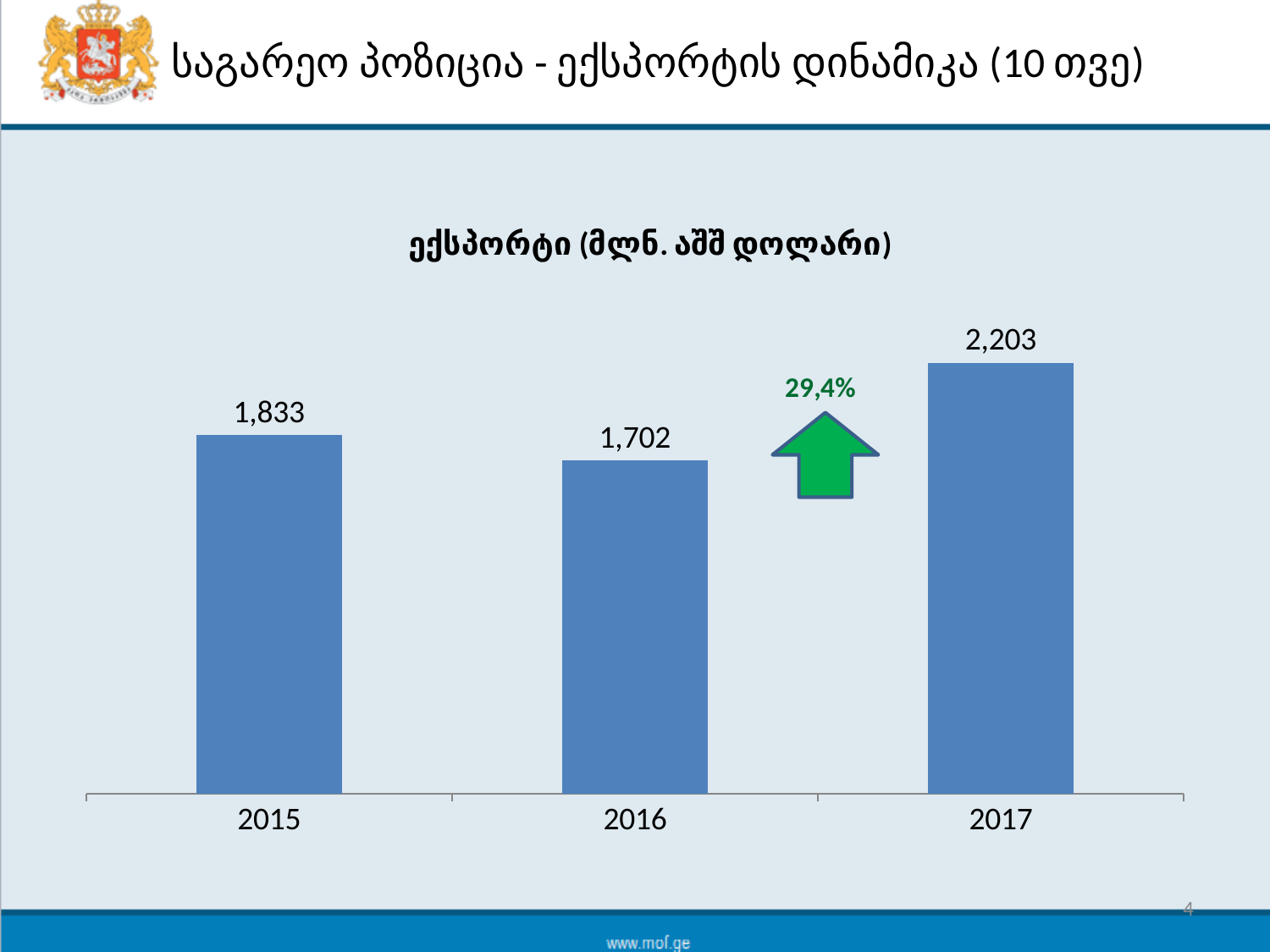
Which year has the highest export value? 2017 How many years are shown on the chart? 3 What is the difference between the export values for 2017 and 2016? 501 Which is larger, the export value for 2015 or for 2017? 2017 What is the export value for 2015? 1,833 What percentage change is shown next to the green arrow on the chart? 29,4% What is the export value for 2016? 1,702 What is the difference between the export values for 2015 and 2016? 131 What kind of chart is shown on the slide? Bar chart Which year has the lowest export value? 2016 What is the title of the chart? ექსპორტი (მლნ. აშშ დოლარი) What is the export value for 2017? 2,203